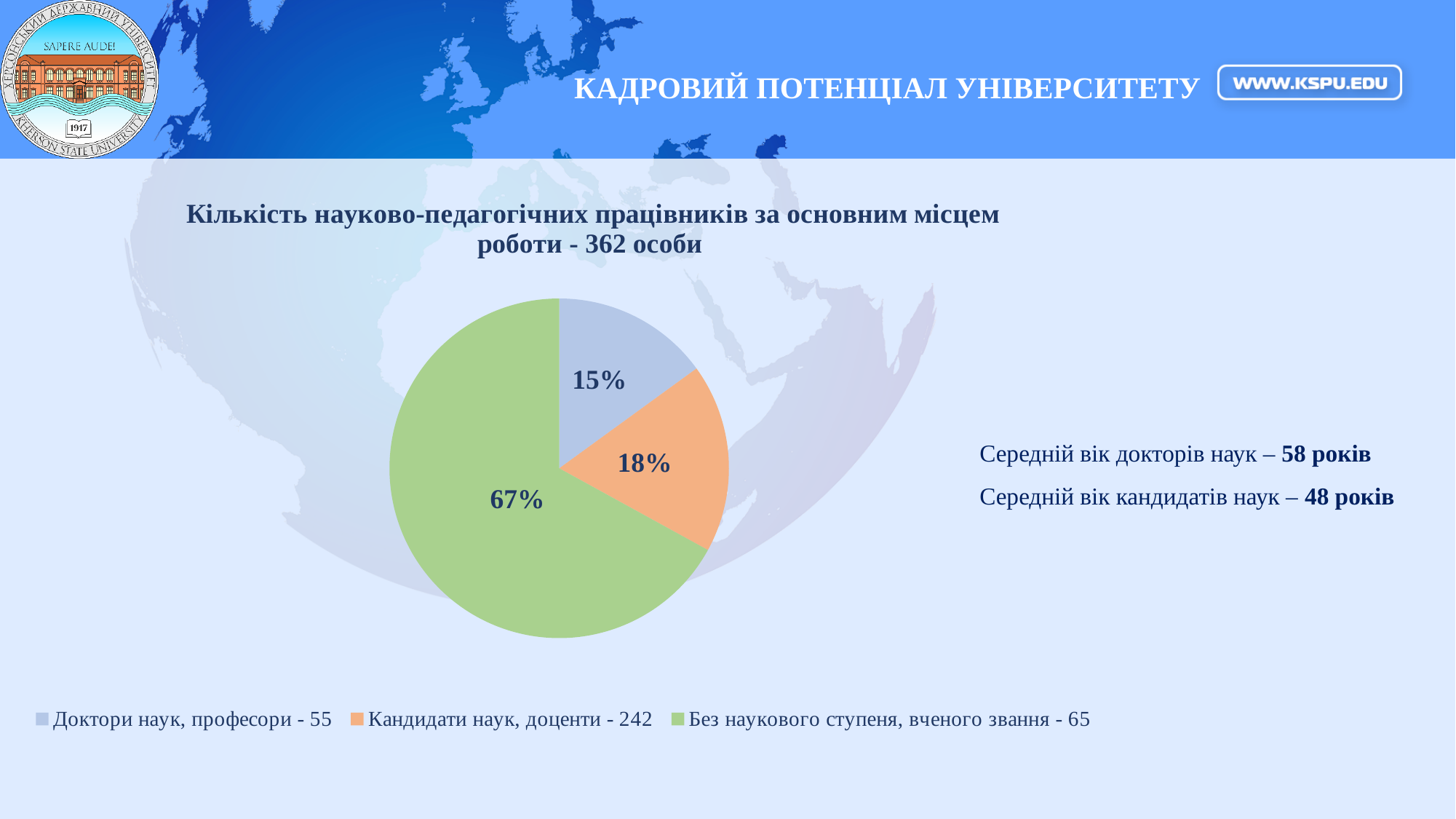
What percentage is shown on the slice for "Доктори наук, професори"? 15% What kind of chart is shown on the slide? pie chart What total number of people is stated in the chart title? 362 особи What is the difference in percentage points between the 67% slice and the 18% slice? 49 Which slice of the pie chart is the largest? Без наукового ступеня, вченого звання How many entries does the legend of the pie chart list? 3 Which slice is larger: "Кандидати наук, доценти" or "Доктори наук, професори"? Кандидати наук, доценти Which slice of the pie chart is the smallest? Доктори наук, професори What percentage is shown on the slice for "Без наукового ступеня, вченого звання"? 67% What colour is the slice labelled 67%? green How many slices does the pie chart have? 3 What percentage is shown on the slice for "Кандидати наук, доценти"? 18%